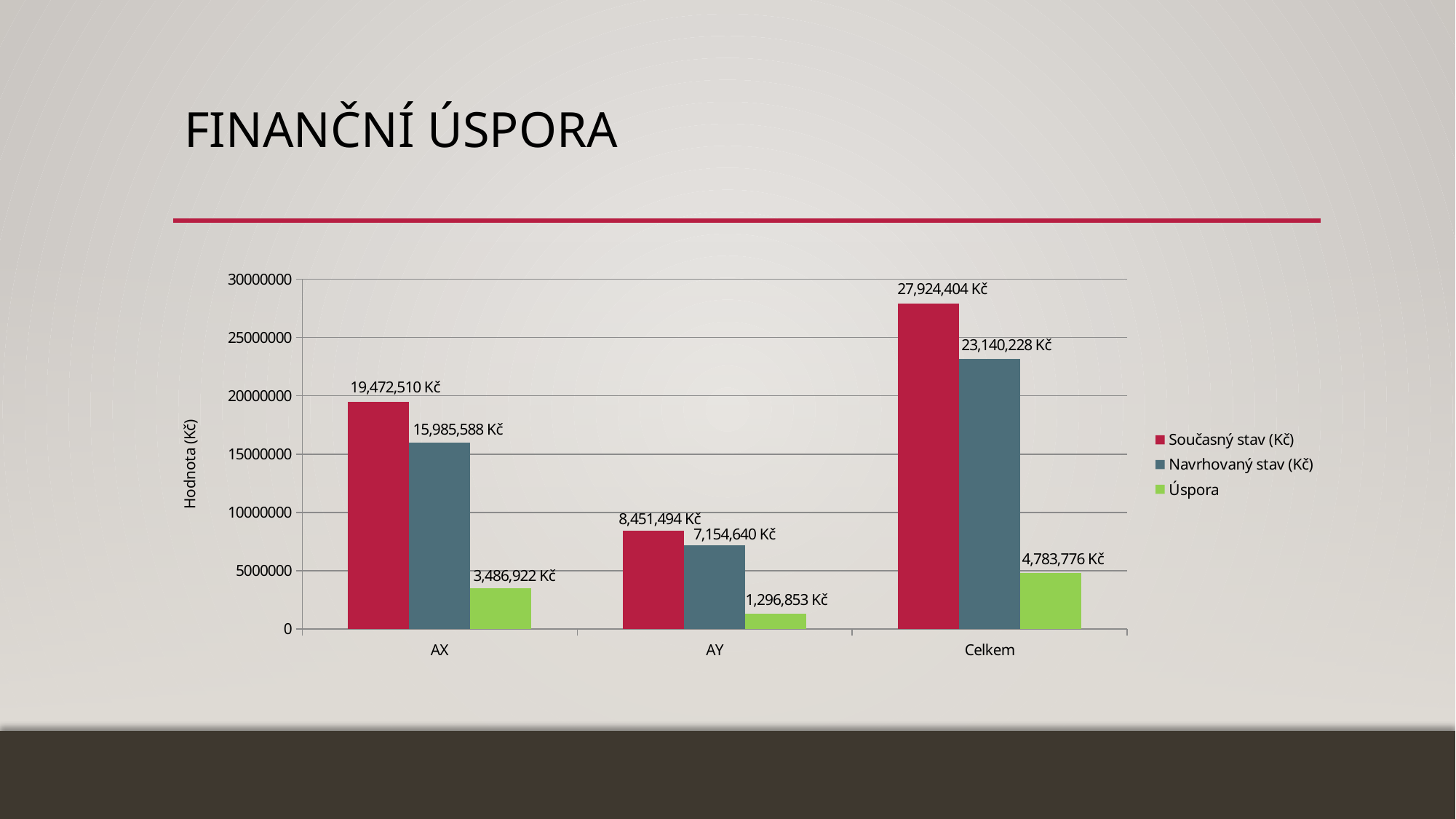
What kind of chart is shown on the slide? bar chart What is the value of Navrhovaný stav (Kč) for Celkem? 23,140,228 Kč Which category has the lowest Úspora value? AY What is the label of the vertical axis? Hodnota (Kč) Which is larger: Navrhovaný stav (Kč) for AX or Současný stav (Kč) for AY? Navrhovaný stav (Kč) for AX How many series does the legend list? 3 How many categories are shown on the x axis? 3 Which category has the highest Současný stav (Kč) value? Celkem What is the difference between Současný stav (Kč) and Navrhovaný stav (Kč) for AX? 3,486,922 Kč What is the value of Současný stav (Kč) for AX? 19,472,510 Kč What is the Úspora value for AY? 1,296,853 Kč Is the Navrhovaný stav (Kč) value for AY greater or less than 10000000? less